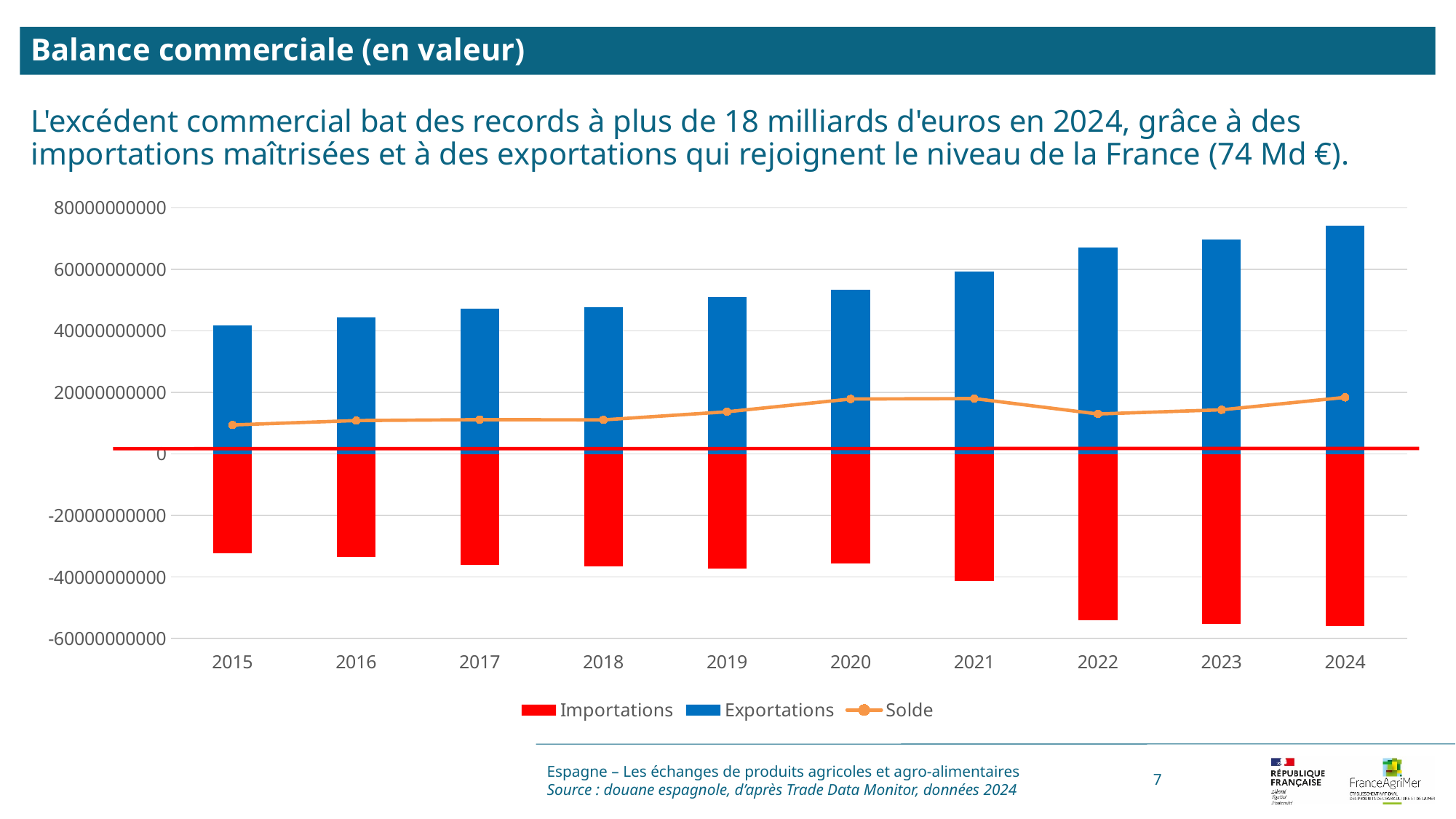
Is the value for Exportations in 2024 greater or less than 60000000000? greater How many years are shown on the x axis of the chart? 10 How many series does the chart legend list? 3 In which year is the Solde line at its lowest point? 2015 Which series is drawn as an orange line in the chart? Solde In which year are Exportations lowest? 2015 In which year are Exportations highest? 2024 What kind of chart is shown on the slide? A combined bar and line chart Is the value for Importations in 2022 greater or less than -40000000000? less Is the value for Exportations in 2019 greater or less than 40000000000? greater Do Exportations generally rise or fall from 2015 to 2024? rise Which is larger, Exportations in 2022 or Exportations in 2018? Exportations in 2022